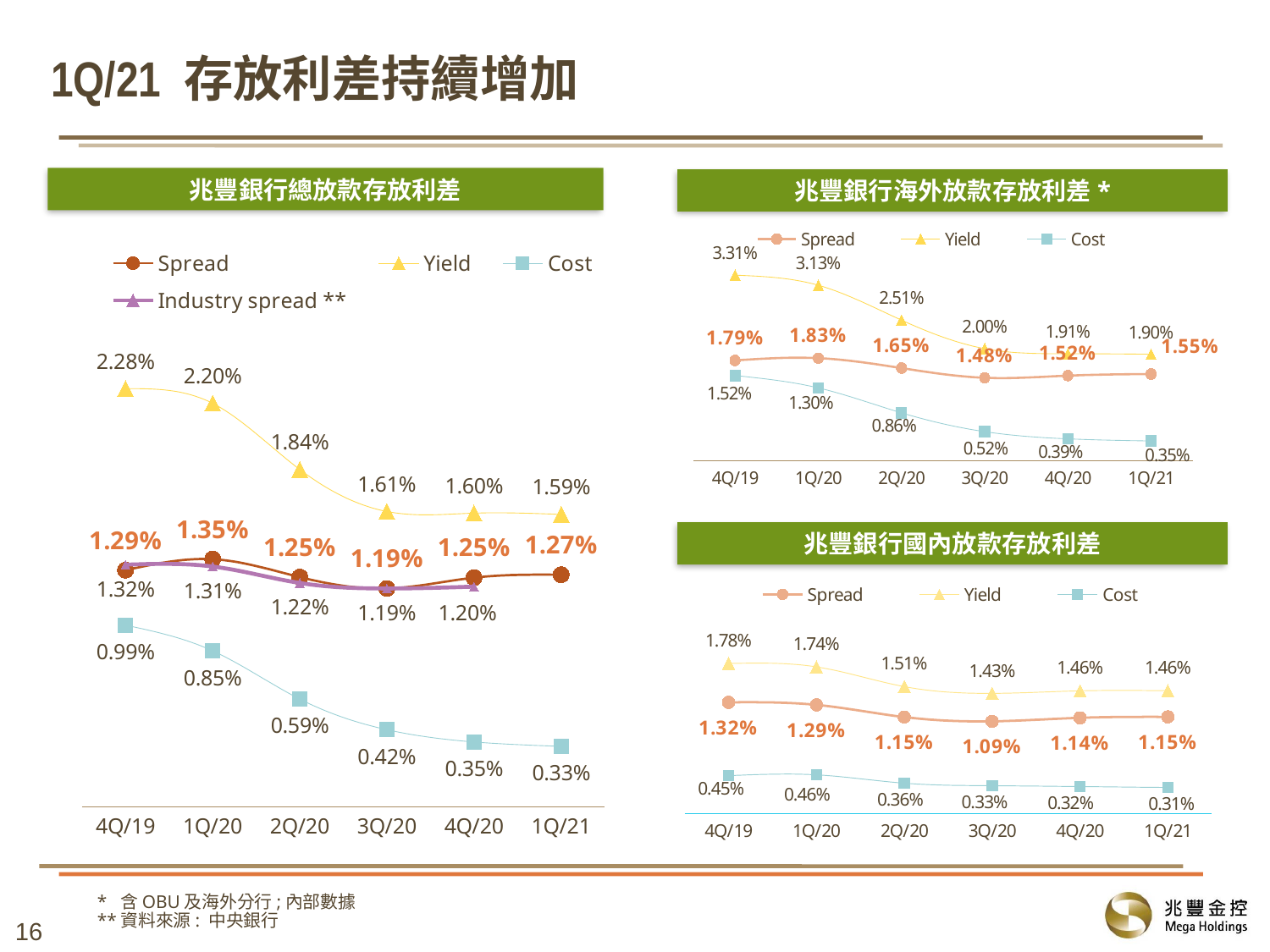
In the 兆豐銀行總放款存放利差 chart, what is the Yield value for 4Q/19? 2.28% In the 兆豐銀行海外放款存放利差 chart, what is the Yield value for 4Q/19? 3.31% In the 兆豐銀行總放款存放利差 chart, in which quarter is the Spread lowest? 3Q/20 In the 兆豐銀行國內放款存放利差 chart, which is larger, the Cost for 4Q/19 or the Cost for 1Q/20? 1Q/20 In the 兆豐銀行國內放款存放利差 chart, what is the Spread value for 3Q/20? 1.09% In the 兆豐銀行海外放款存放利差 chart, in which quarter is the Spread highest? 1Q/20 In the 兆豐銀行總放款存放利差 chart, what is the Spread value for 1Q/21? 1.27% In the 兆豐銀行海外放款存放利差 chart, what is the Cost value for 1Q/21? 0.35% In the 兆豐銀行總放款存放利差 chart, how many series does the legend list? 4 In the 兆豐銀行總放款存放利差 chart, what is the difference between the Yield and Cost values for 1Q/21? 1.26% In the 兆豐銀行總放款存放利差 chart, does the Cost series rise or fall from 4Q/19 to 1Q/21? Fall What kind of chart is the 兆豐銀行國內放款存放利差 chart? Line chart